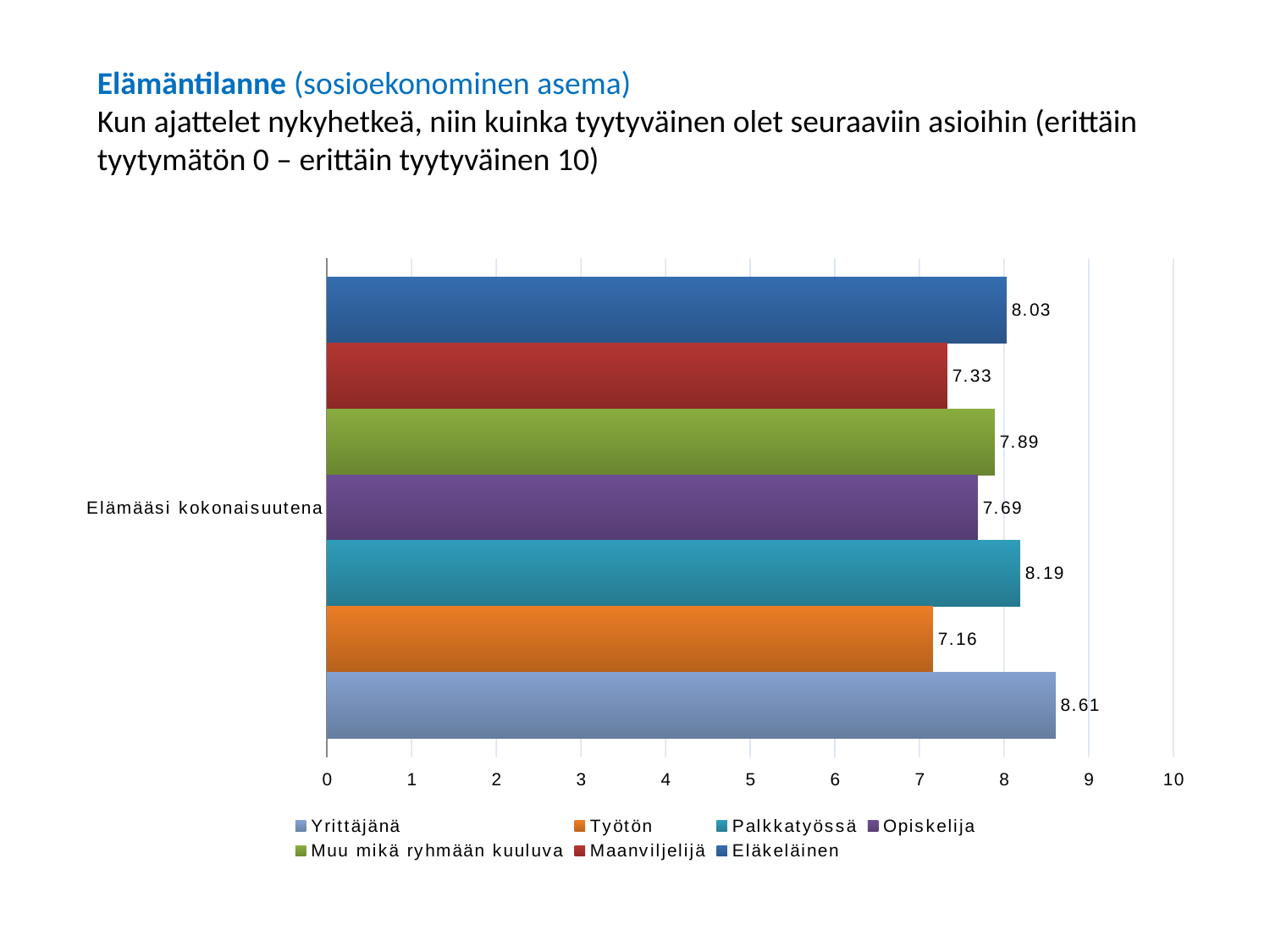
What is the difference between the values for Eläkeläinen and Opiskelija? 0.34 Which is larger, the value for Muu mikä ryhmään kuuluva or the value for Maanviljelijä? Muu mikä ryhmään kuuluva How many series does the legend list? 7 What is the value for Työtön? 7.16 What kind of chart is shown on the slide? bar chart What is the value for Maanviljelijä? 7.33 Which series has the lowest value? Työtön What is the value for Palkkatyössä? 8.19 Is the value for Opiskelija greater or less than 8? less What is the difference between the values for Yrittäjänä and Työtön? 1.45 Which series has the highest value? Yrittäjänä What is the value for Yrittäjänä? 8.61